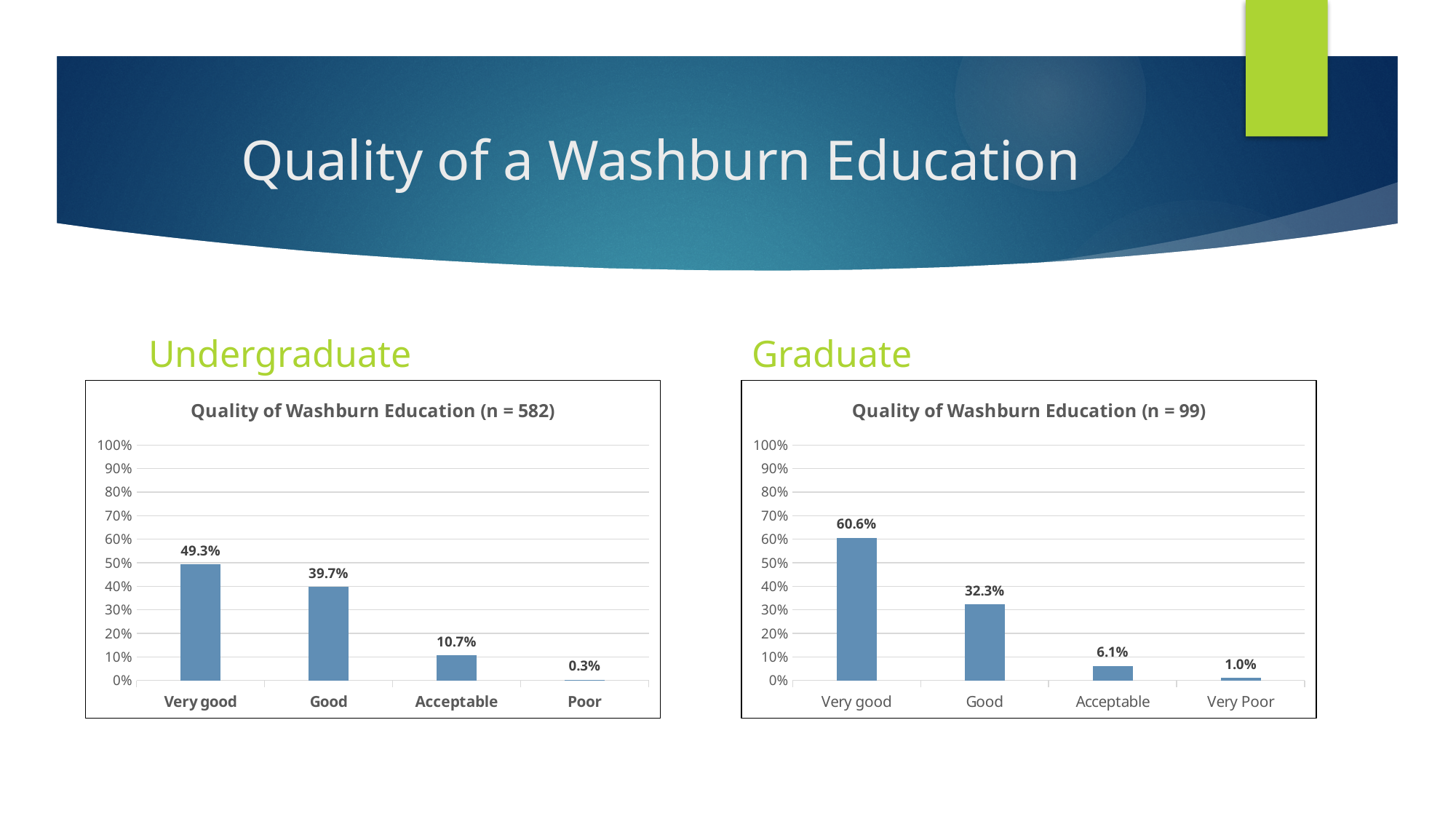
In the Graduate chart, what is the value for Good? 32.3% In the Graduate chart, is the value for Very good greater or less than 50%? greater In the Undergraduate chart, what is the value for Very good? 49.3% In the Undergraduate chart, which category has the lowest value? Poor In the Graduate chart, what is the difference between Very good and Good? 28.3% How many categories are shown in the Undergraduate chart? 4 What is the title of the Graduate chart? Quality of Washburn Education (n = 99) In the Undergraduate chart, what is the value for Poor? 0.3% What kind of chart is the Graduate chart? bar chart Which is larger: Very good in the Undergraduate chart or Very good in the Graduate chart? Graduate In the Undergraduate chart, what is the difference between Good and Acceptable? 29.0% In the Graduate chart, which category has the highest value? Very good